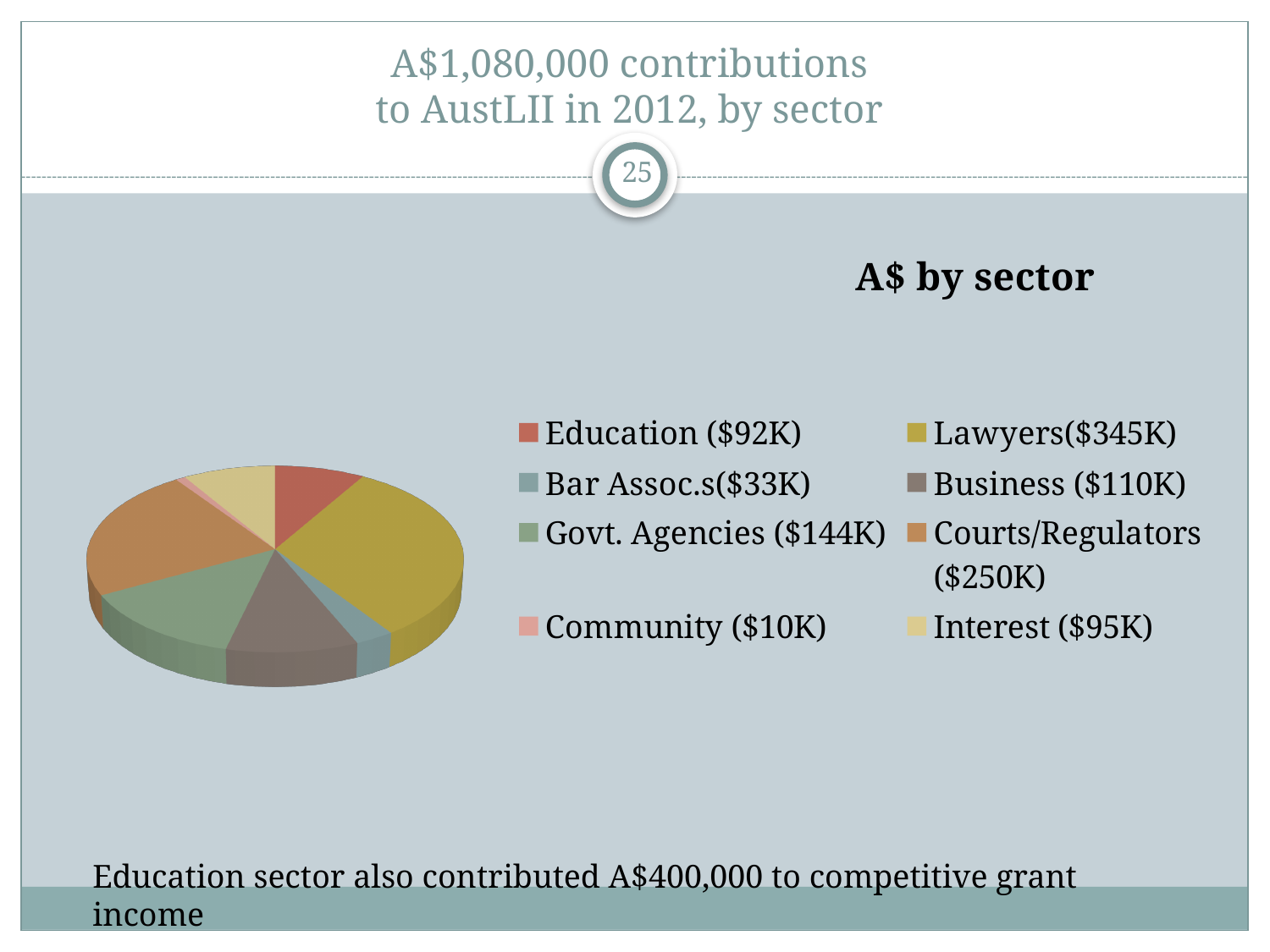
What is the difference between the Interest and Education amounts? $3K Which sector contributed the largest amount? Lawyers Which contributed more, Govt. Agencies or Business? Govt. Agencies What is the title of the chart? A$ by sector What amount is shown for Courts/Regulators? $250K What amount is shown for Bar Assoc.s? $33K Which sector contributed the smallest amount? Community What kind of chart is shown on the slide? Pie chart How much more did Lawyers contribute than Courts/Regulators? $95K What amount is shown for Govt. Agencies? $144K How many sectors (slices) does the pie chart show? 8 What amount did Lawyers contribute according to the legend? $345K